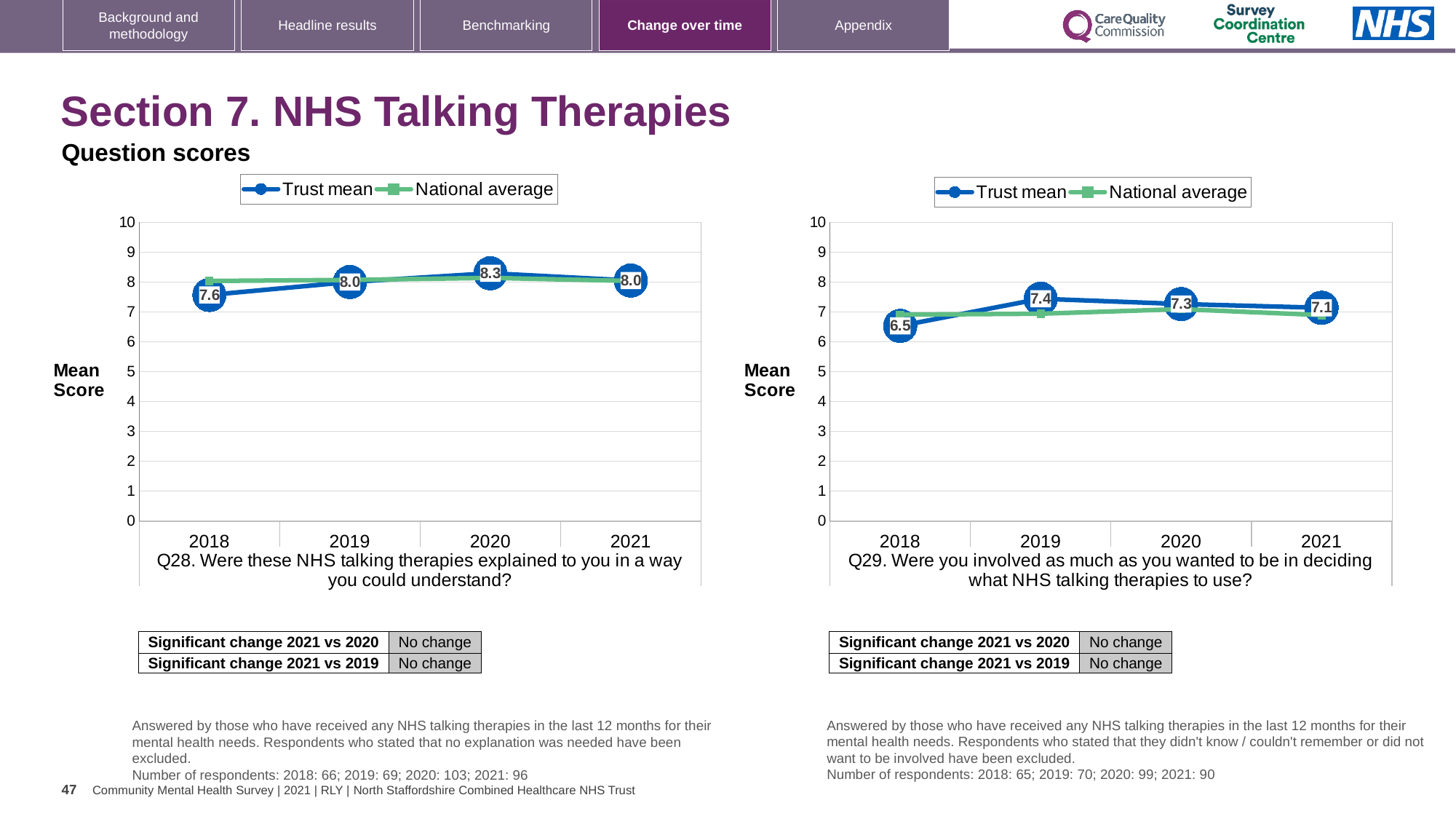
In the Q28 chart (left), which year has the highest Trust mean score? 2020 How many series does the legend of the Q28 chart (left) list? 2 How many years are plotted on the x axis of the Q29 chart (right)? 4 In the Q29 chart (right), which year has the lowest Trust mean score? 2018 In the Q29 chart (right), what is the difference between the Trust mean scores for 2019 and 2018? 0.9 In the Q28 chart (left), what is the Trust mean score for 2020? 8.3 In the Q28 chart (left), what is the difference between the Trust mean scores for 2020 and 2018? 0.7 In the Q29 chart (right), what is the Trust mean score for 2019? 7.4 In the Q29 chart (right), what is the Trust mean score for 2021? 7.1 What kind of chart is the Q28 chart (left)? Line chart In the Q29 chart (right), is the Trust mean score for 2018 greater or less than 7? less In the Q28 chart (left), what is the Trust mean score for 2018? 7.6